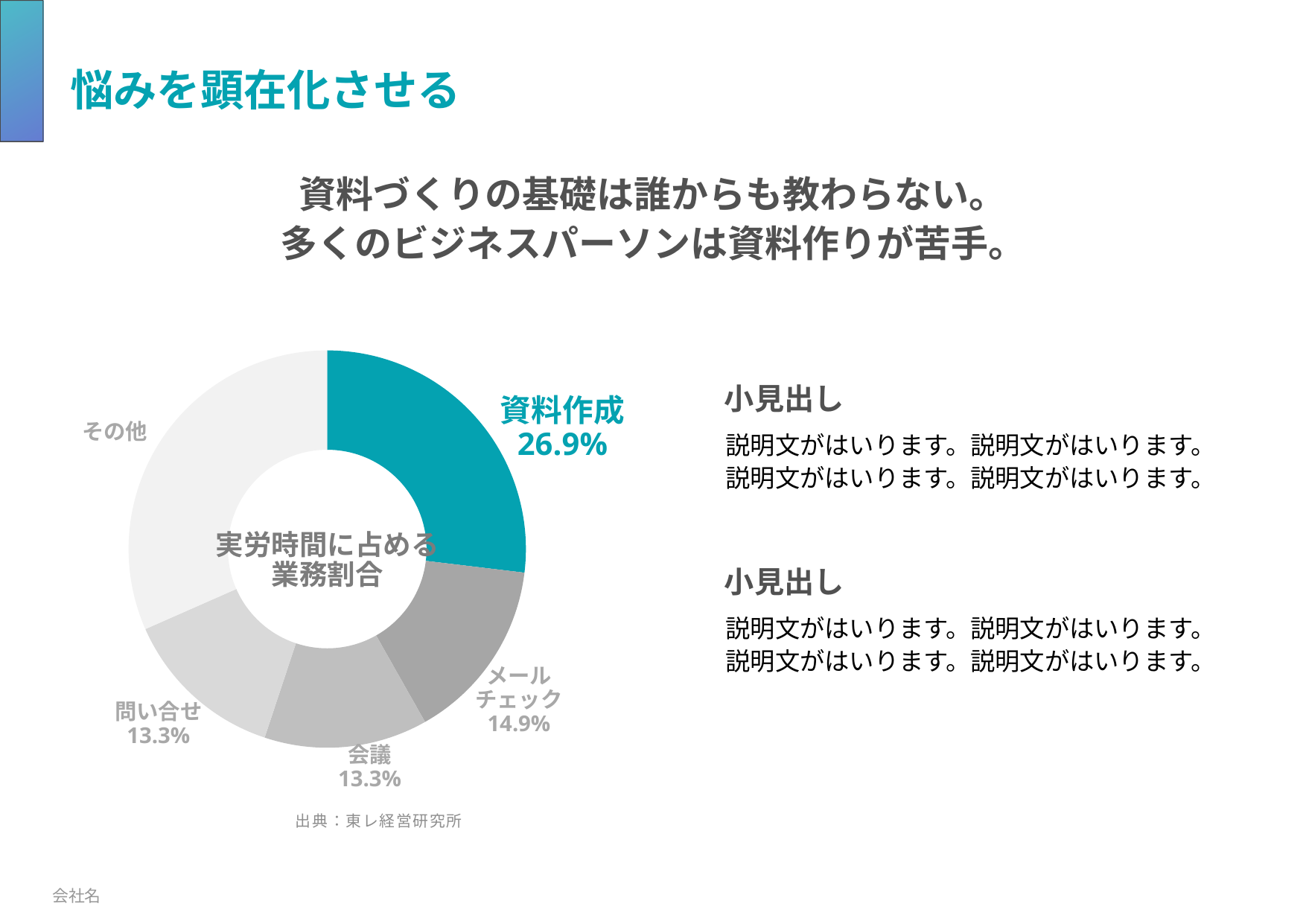
What is the value for メールチェック in the donut chart? 14.9% What is the difference between the values for 資料作成 and メールチェック in the donut chart? 12.0% What source is cited below the donut chart? 東レ経営研究所 What is the value for 会議 in the donut chart? 13.3% What is the difference between the values for メールチェック and 会議 in the donut chart? 1.6% What is the title shown in the centre of the donut chart? 実労時間に占める業務割合 Which is larger in the donut chart, メールチェック or 会議? メールチェック What is the value for 問い合せ in the donut chart? 13.3% What is the value for 資料作成 in the donut chart? 26.9% Which is larger in the donut chart, 資料作成 or メールチェック? 資料作成 What kind of chart is shown on the slide? Donut (pie) chart How many slices does the donut chart have? 5